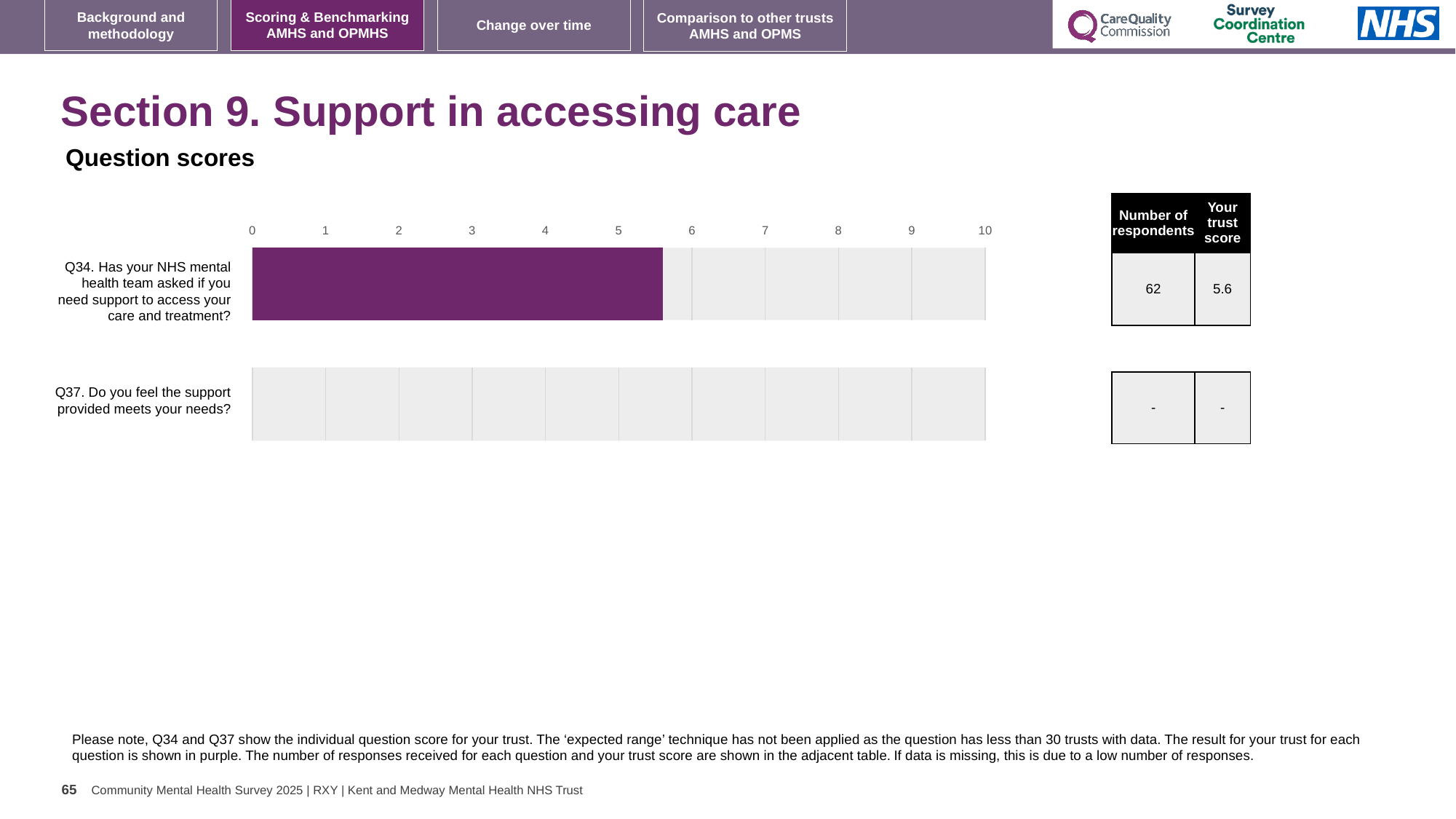
Is the value for Q34 greater or less than 6? less What is the trust score for Q34 (Has your NHS mental health team asked if you need support to access your care and treatment?)? 5.6 What colour is the bar for Q34? purple How many respondents are shown for Q34? 62 What kind of chart is shown on the slide? bar chart Is the value for Q34 greater or less than 3? greater What is shown as the trust score for Q37 (Do you feel the support provided meets your needs?)? - How many questions are listed on the chart? 2 What is the range of the chart's horizontal axis? 0 to 10 What is shown as the number of respondents for Q37? - Is the value for Q34 greater or less than 5? greater